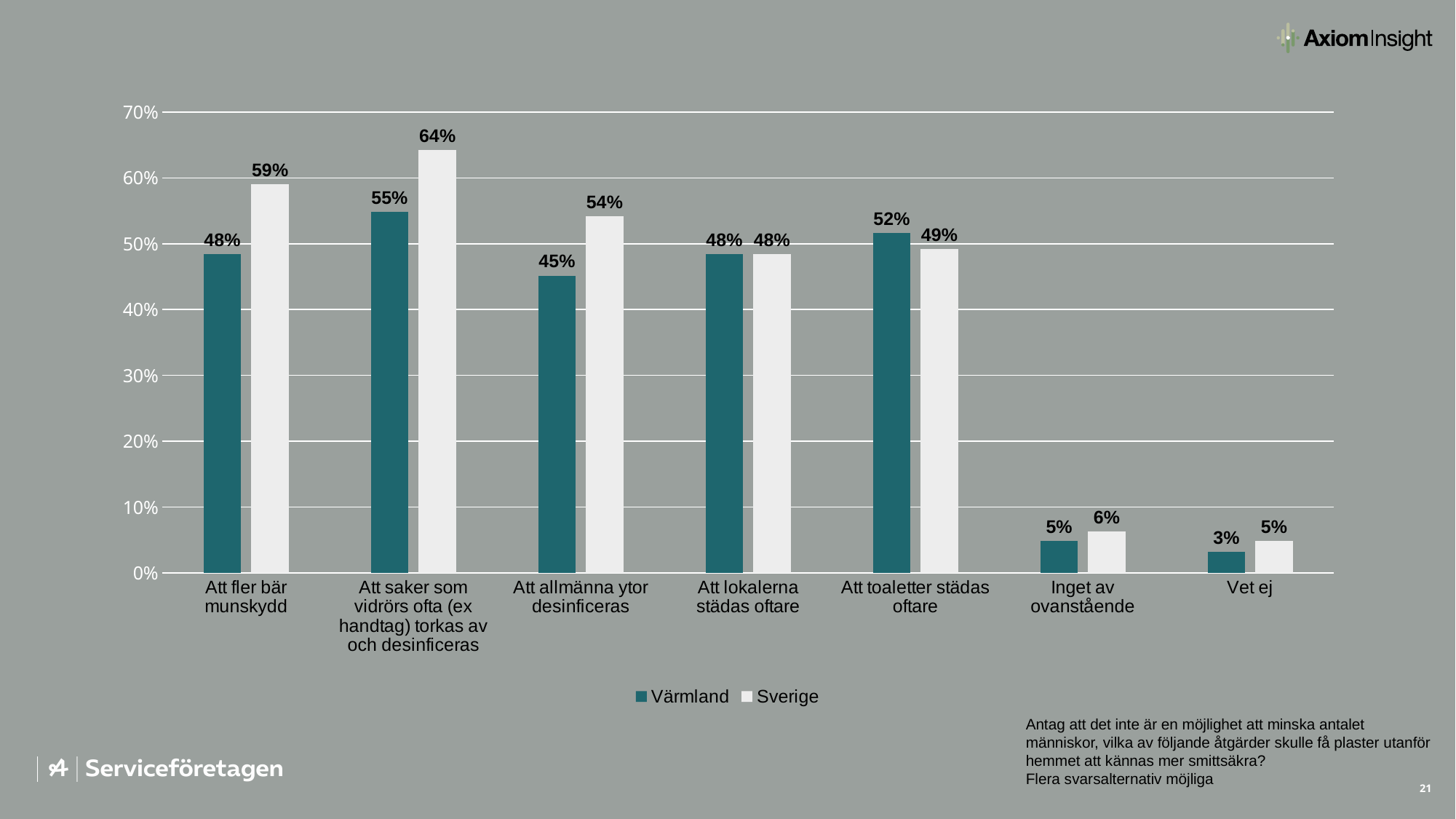
What is the value for Värmland for 'Att toaletter städas oftare'? 52% Which category has the lowest value for Värmland? Vet ej What kind of chart is shown on the slide? Bar chart Which series is shown in dark teal in the legend? Värmland How many categories are shown on the x axis? 7 What is the difference between the Sverige and Värmland values for 'Att fler bär munskydd'? 11 percentage points What is the value for Sverige for 'Att saker som vidrörs ofta (ex handtag) torkas av och desinficeras'? 64% How many series does the legend list? 2 Which category has the highest value for Sverige? Att saker som vidrörs ofta (ex handtag) torkas av och desinficeras What is the value for Värmland for 'Att fler bär munskydd'? 48% Is the Sverige value for 'Att allmänna ytor desinficeras' greater or less than 50%? greater Which is larger for 'Att toaletter städas oftare': Värmland or Sverige? Värmland